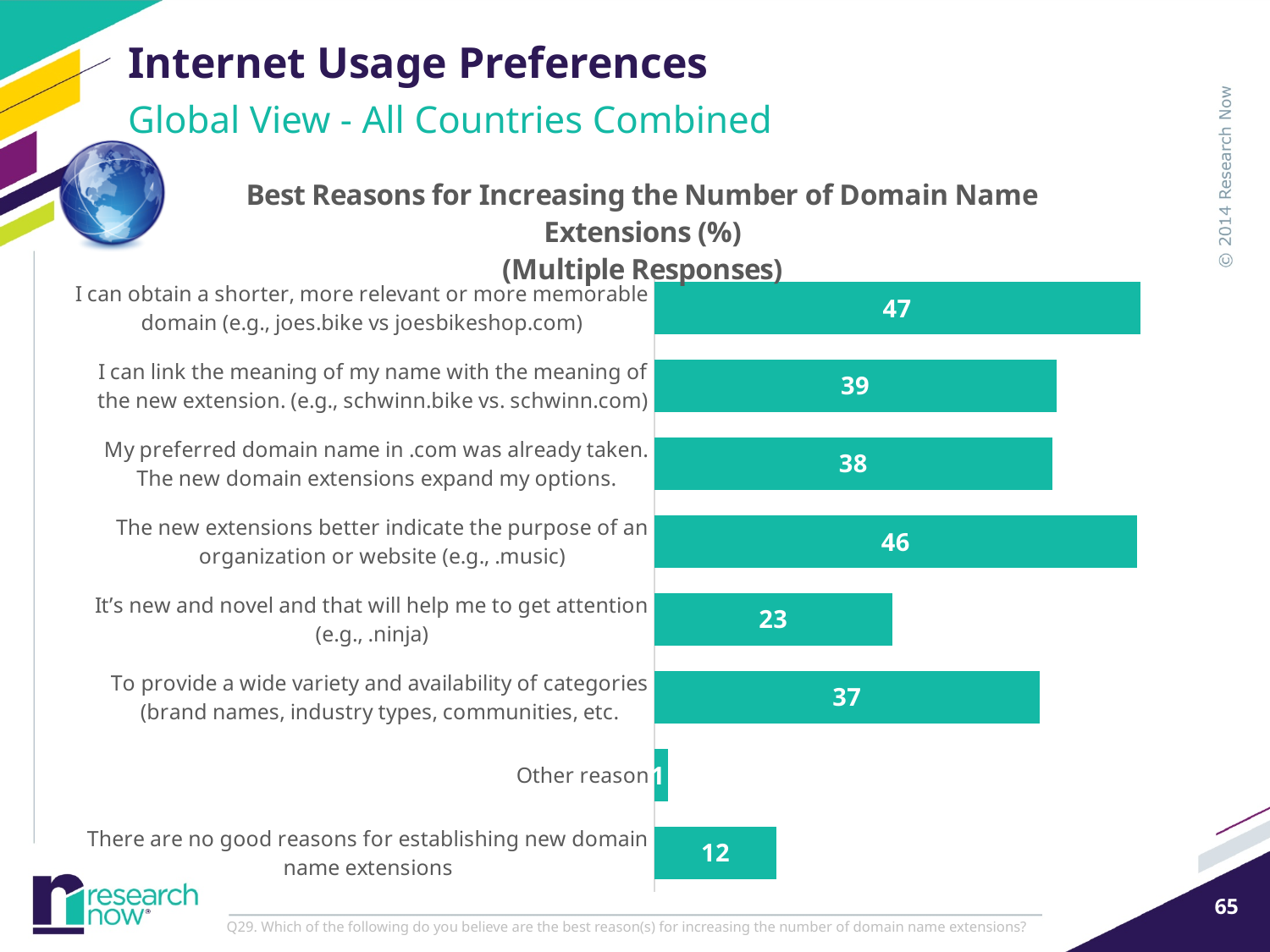
Which category has the lowest value? Other reason What is the difference between the highest value and the value for "It's new and novel and that will help me to get attention (e.g., .ninja)"? 24 What is the value for "Other reason"? 1 How many categories are shown in the chart? 8 What is the difference between the values for "I can link the meaning of my name with the meaning of the new extension" and "My preferred domain name in .com was already taken"? 1 What is the value for "I can obtain a shorter, more relevant or more memorable domain (e.g., joes.bike vs joesbikeshop.com)"? 47 What is the value for "It's new and novel and that will help me to get attention (e.g., .ninja)"? 23 What is the value for "There are no good reasons for establishing new domain name extensions"? 12 Which reason has the highest value? I can obtain a shorter, more relevant or more memorable domain (e.g., joes.bike vs joesbikeshop.com) What kind of chart is shown on the slide? Bar chart What is the title of the chart? Best Reasons for Increasing the Number of Domain Name Extensions (%) (Multiple Responses) Which is larger: the value for "The new extensions better indicate the purpose of an organization or website (e.g., .music)" or the value for "To provide a wide variety and availability of categories"? The new extensions better indicate the purpose of an organization or website (e.g., .music)